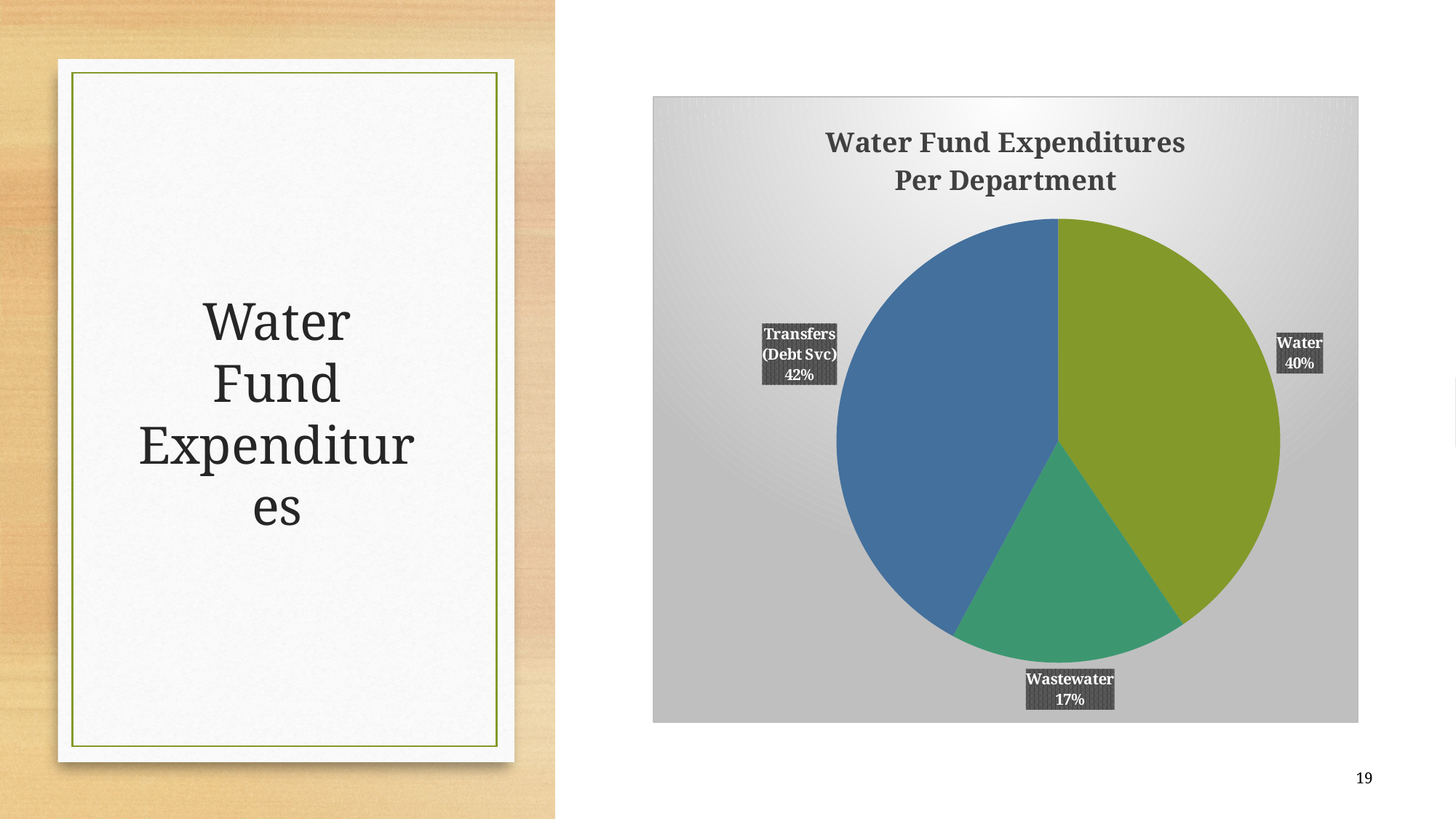
Which department has the largest share of Water Fund Expenditures? Transfers (Debt Svc) What kind of chart is shown on the slide? Pie chart Which is larger, the Water share or the Wastewater share? Water Which department has the smallest share of Water Fund Expenditures? Wastewater What share of Water Fund Expenditures goes to Wastewater? 17% What share of Water Fund Expenditures goes to Transfers (Debt Svc)? 42% What colour is the Wastewater slice? Green (teal) What is the title of the chart? Water Fund Expenditures Per Department How many slices does the pie chart have? 3 How many percentage points larger is the Transfers (Debt Svc) share than the Wastewater share? 25% What share of Water Fund Expenditures goes to Water? 40% How many percentage points larger is the Water share than the Wastewater share? 23%